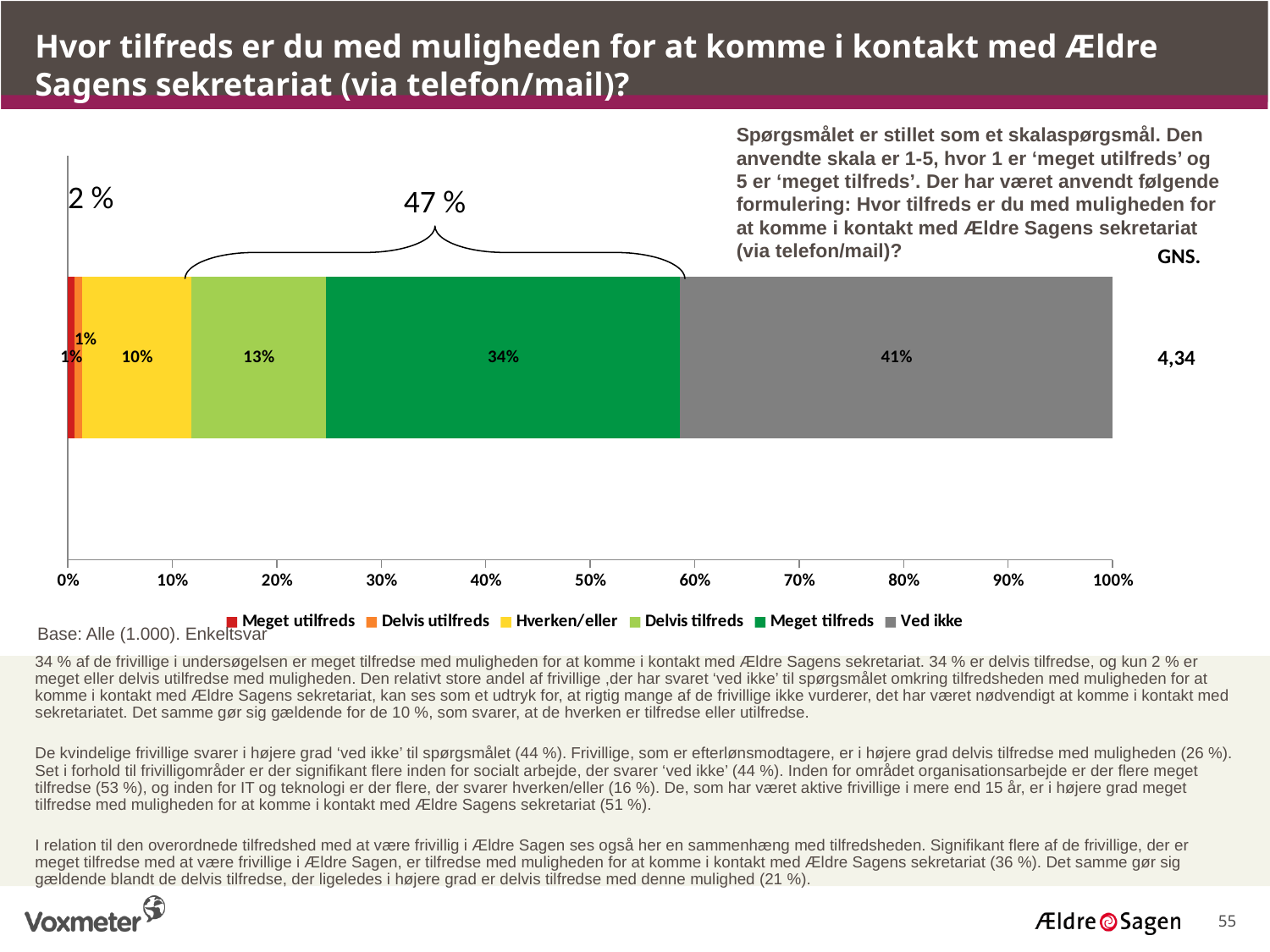
What percentage of respondents answered 'Ved ikke'? 41% What is the difference in percentage points between 'Ved ikke' and 'Meget tilfreds'? 7 What colour is the 'Meget tilfreds' segment in the legend? Dark green What percentage of respondents answered 'Hverken/eller'? 10% What percentage of respondents answered 'Meget tilfreds'? 34% Which response category has the largest share of the bar? Ved ikke How many series does the legend list? 6 What average (GNS.) value is shown to the right of the bar? 4,34 What kind of chart is shown on the slide? Stacked bar chart What is the combined share of 'Delvis tilfreds' and 'Meget tilfreds' as shown by the bracket above the bar? 47 % Which is larger, the share for 'Delvis tilfreds' or the share for 'Hverken/eller'? Delvis tilfreds What percentage of respondents answered 'Delvis tilfreds'? 13%